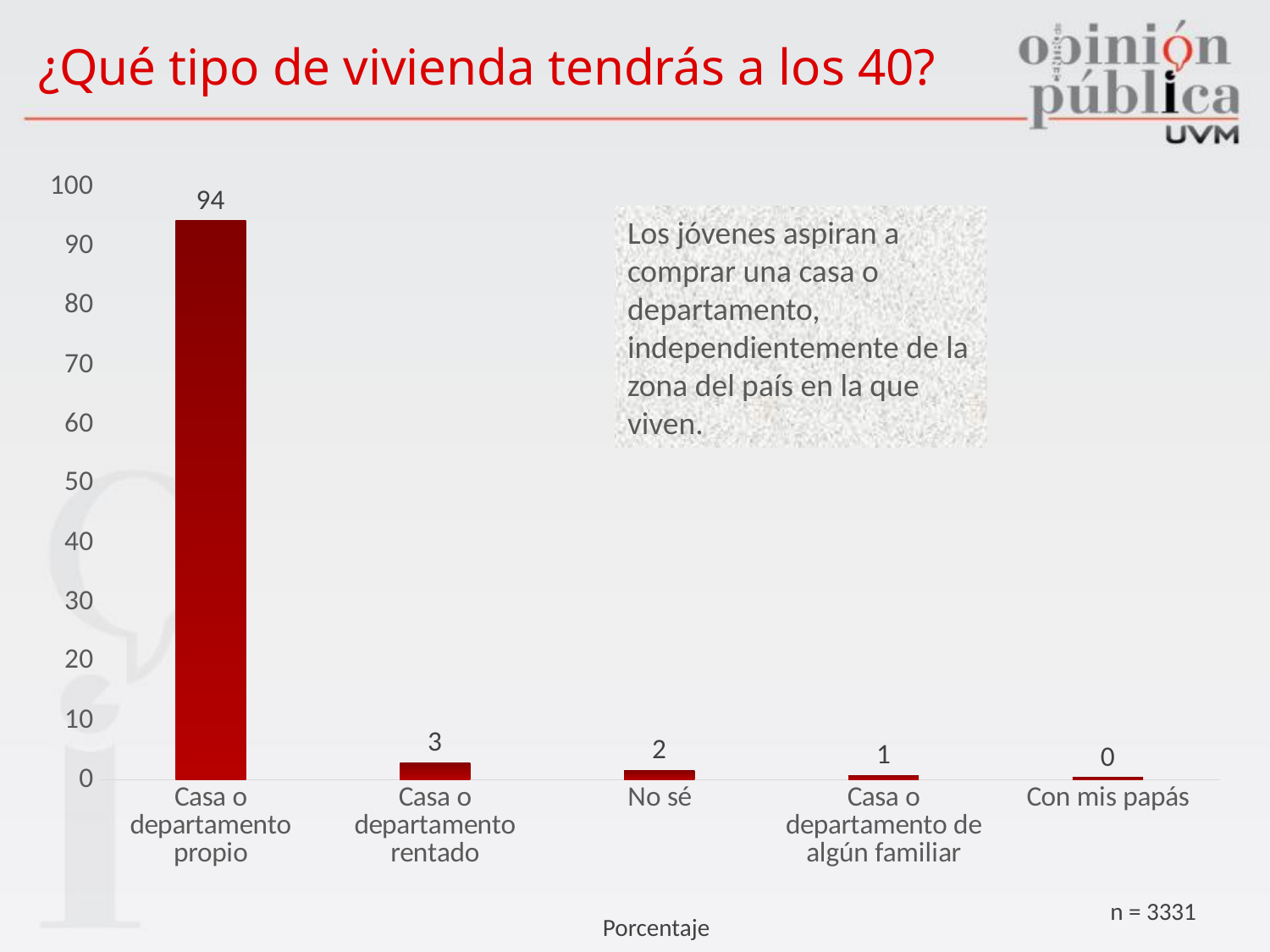
How many categories are shown on the chart? 5 What is the value for "Casa o departamento propio"? 94 What is the value for "Con mis papás"? 0 What is the sample size (n) shown on the slide? 3331 What is the value for "No sé"? 2 What is the value for "Casa o departamento rentado"? 3 Which is larger, the value for "No sé" or the value for "Casa o departamento de algún familiar"? No sé Is the value for "Casa o departamento propio" greater or less than 90? greater Which category has the lowest value? Con mis papás What kind of chart is shown on the slide? bar chart What is the difference between the values for "Casa o departamento propio" and "Casa o departamento rentado"? 91 Which category has the highest value? Casa o departamento propio